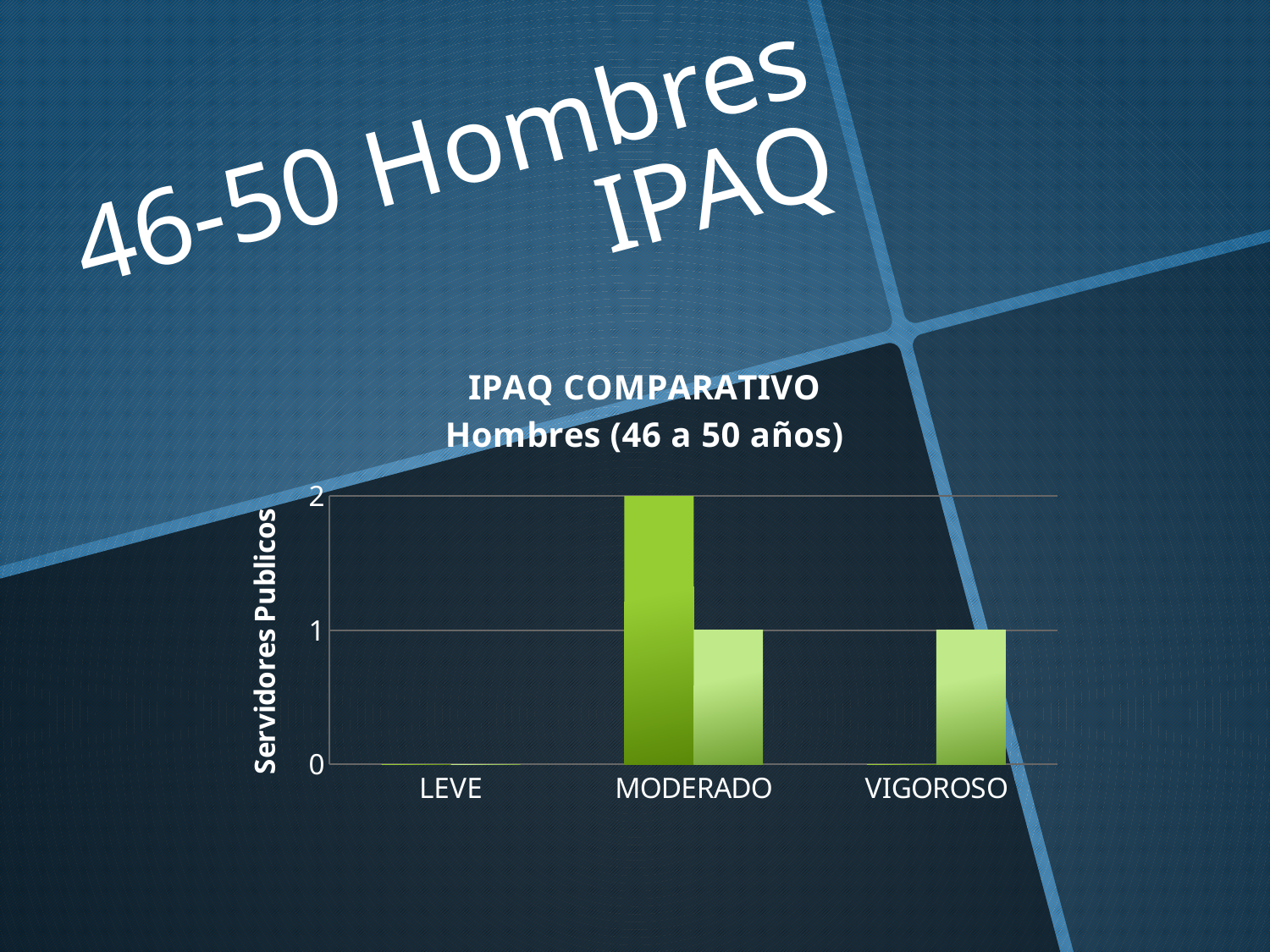
What kind of chart is shown on the slide? bar chart What is the label of the vertical axis of the chart? Servidores Publicos What is the value of the darker green bar for MODERADO? 2 What is the difference between the darker green bar and the lighter green bar for MODERADO? 1 What is the title of the chart? IPAQ COMPARATIVO Hombres (46 a 50 años) What is the value of the lighter green bar for VIGOROSO? 1 Which category has the tallest bar in the chart? MODERADO Which category has no bars plotted at all? LEVE What is the value of the lighter green bar for MODERADO? 1 How many bars are plotted in the chart? 3 How many categories are shown on the x axis of the chart? 3 Which is larger: the darker green bar for MODERADO or the lighter green bar for VIGOROSO? the darker green bar for MODERADO